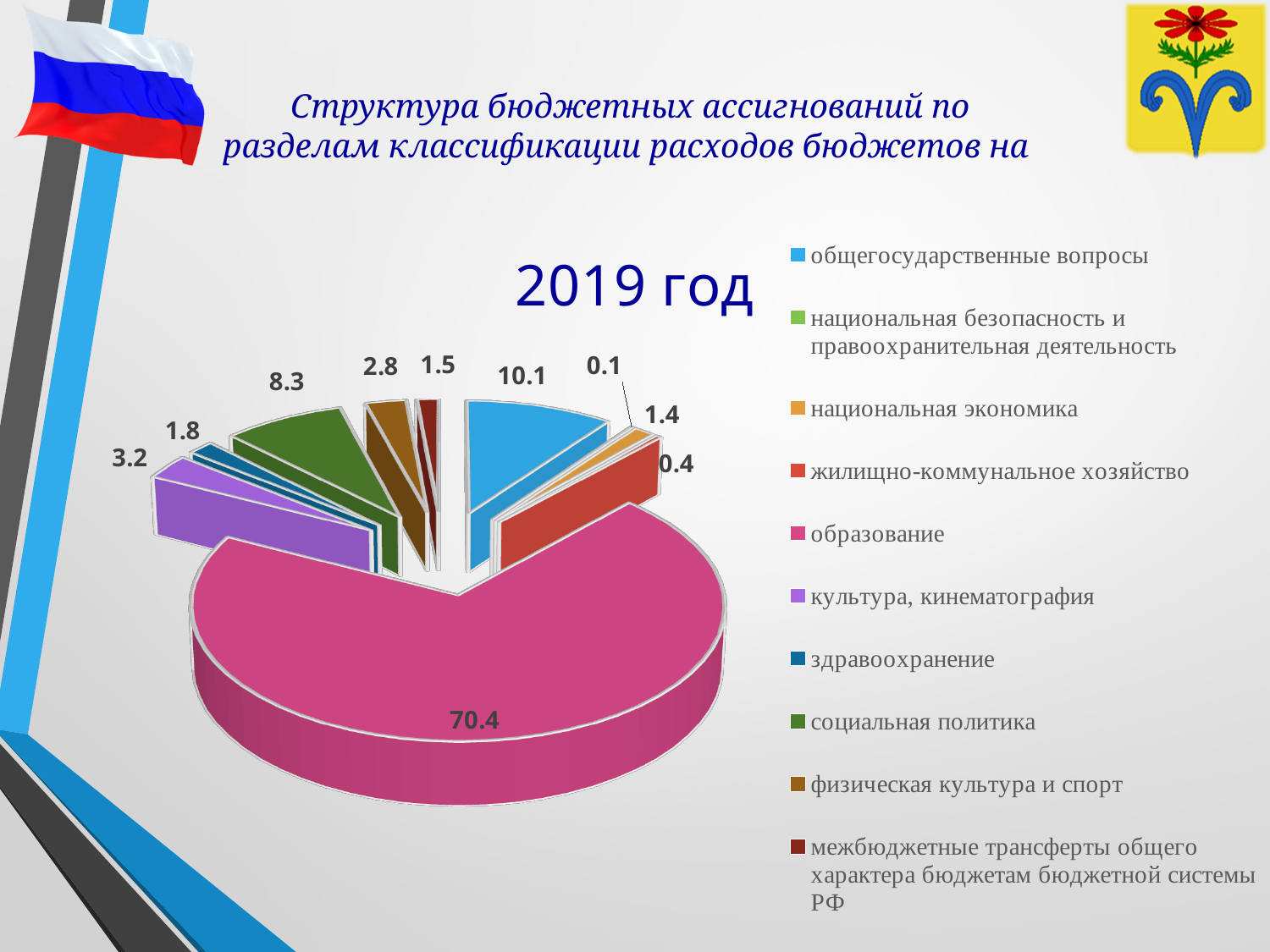
Which category has the largest slice of the pie? образование What is the value shown for социальная политика? 8.3 What is the value shown for культура, кинематография? 3.2 What is the value shown for физическая культура и спорт? 2.8 What is the value shown for здравоохранение? 1.8 What is the value shown for общегосударственные вопросы? 10.1 Which is larger, the value for социальная политика or the value for культура, кинематография? социальная политика What type of chart is shown on the slide? pie chart How many categories does the legend list? 10 What is the difference between the values for общегосударственные вопросы and социальная политика? 1.8 What is the value shown for образование in the pie chart? 70.4 Which category has the smallest slice of the pie? национальная безопасность и правоохранительная деятельность